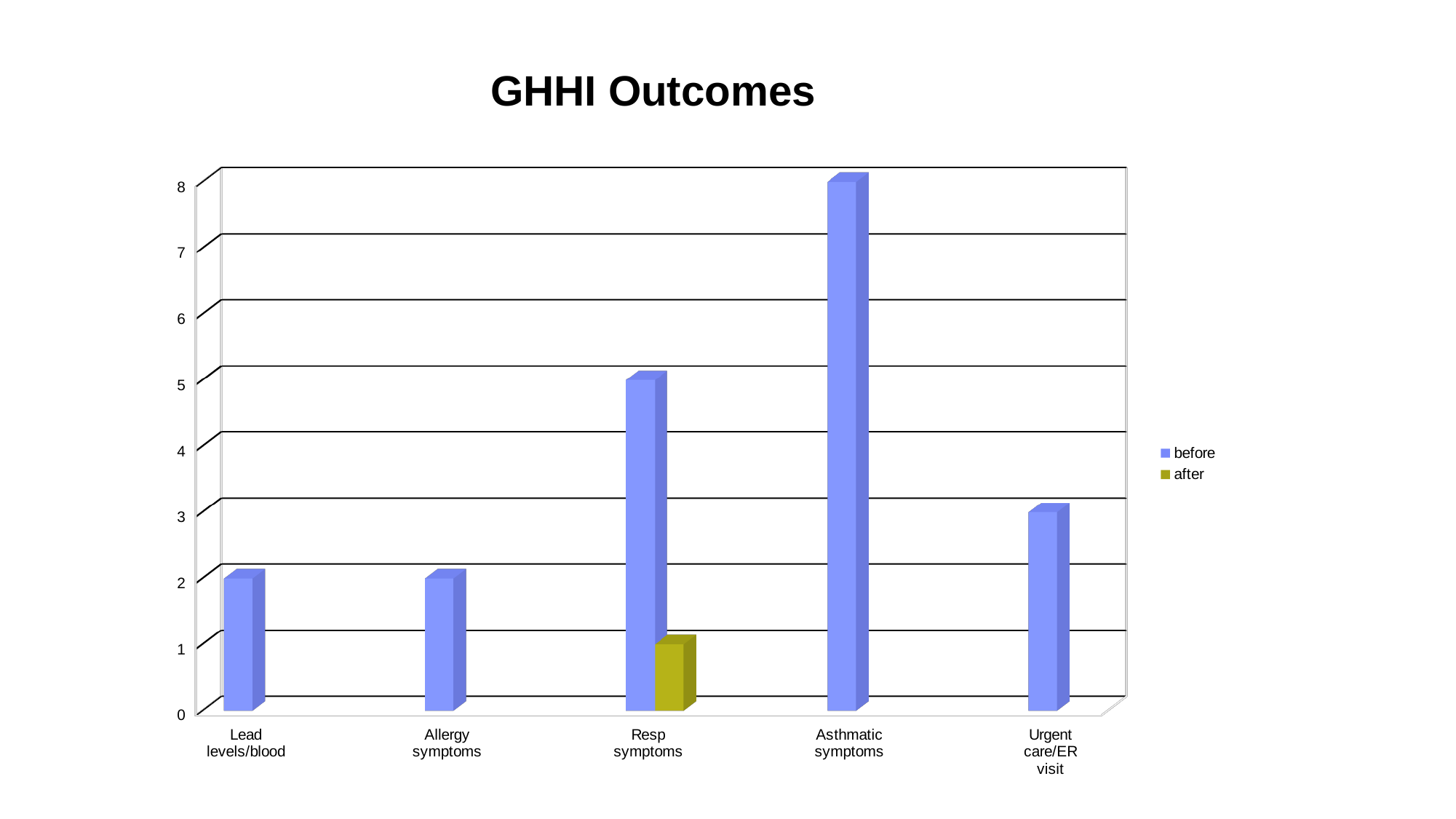
Is the 'before' value for Asthmatic symptoms greater or less than 6? greater What is the title of the chart? GHHI Outcomes What is the 'before' value for Resp symptoms? 5 What type of chart is shown on the slide? bar chart What is the 'before' value for Asthmatic symptoms? 8 What is the 'after' value for Resp symptoms? 1 What is the 'before' value for Urgent care/ER visit? 3 Which category has the highest 'before' value? Asthmatic symptoms How many categories are shown on the x axis? 5 How many series does the legend list? 2 Which category is the only one with a visible 'after' bar? Resp symptoms Which is larger, the 'before' value for Resp symptoms or the 'before' value for Urgent care/ER visit? Resp symptoms